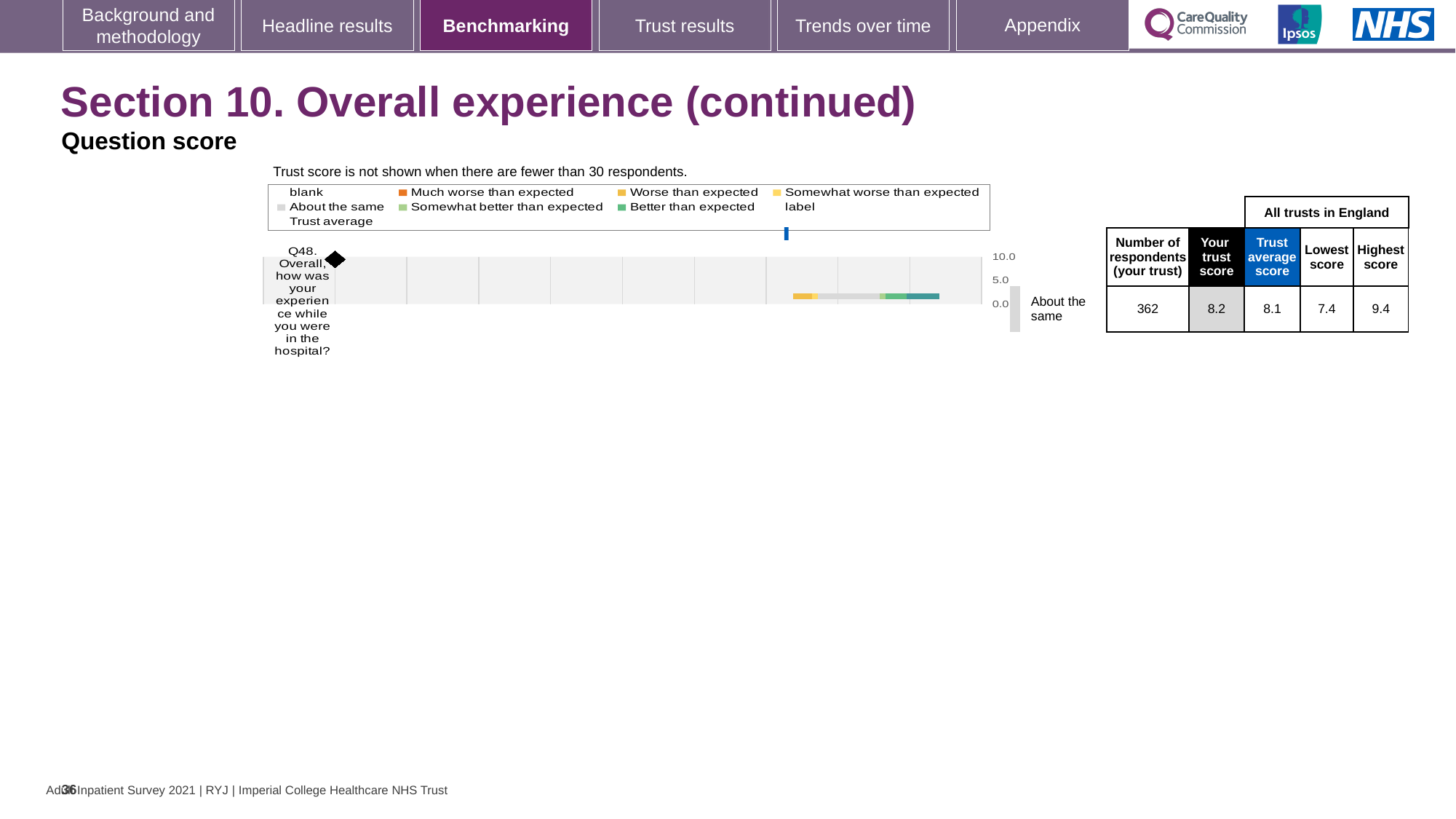
In the table beside the chart, what is your trust score for Q48? 8.2 What benchmark category label is shown next to the chart for Q48? About the same In the table beside the chart, what is the trust average score for Q48? 8.1 How many entries does the chart legend list? 9 In the table beside the chart, what is the lowest score among all trusts in England for Q48? 7.4 In the table beside the chart, what is the difference between the highest score and the lowest score for Q48? 2.0 What kind of chart is shown on the slide? bar chart In the table beside the chart, what is the number of respondents for your trust for Q48? 362 What is the highest value shown on the chart's axis? 10.0 Which question is plotted in the chart? Q48. Overall, how was your experience while you were in the hospital? How many questions (categories) are plotted in the chart? 1 In the table beside the chart, which is larger for Q48: your trust score or the trust average score? Your trust score